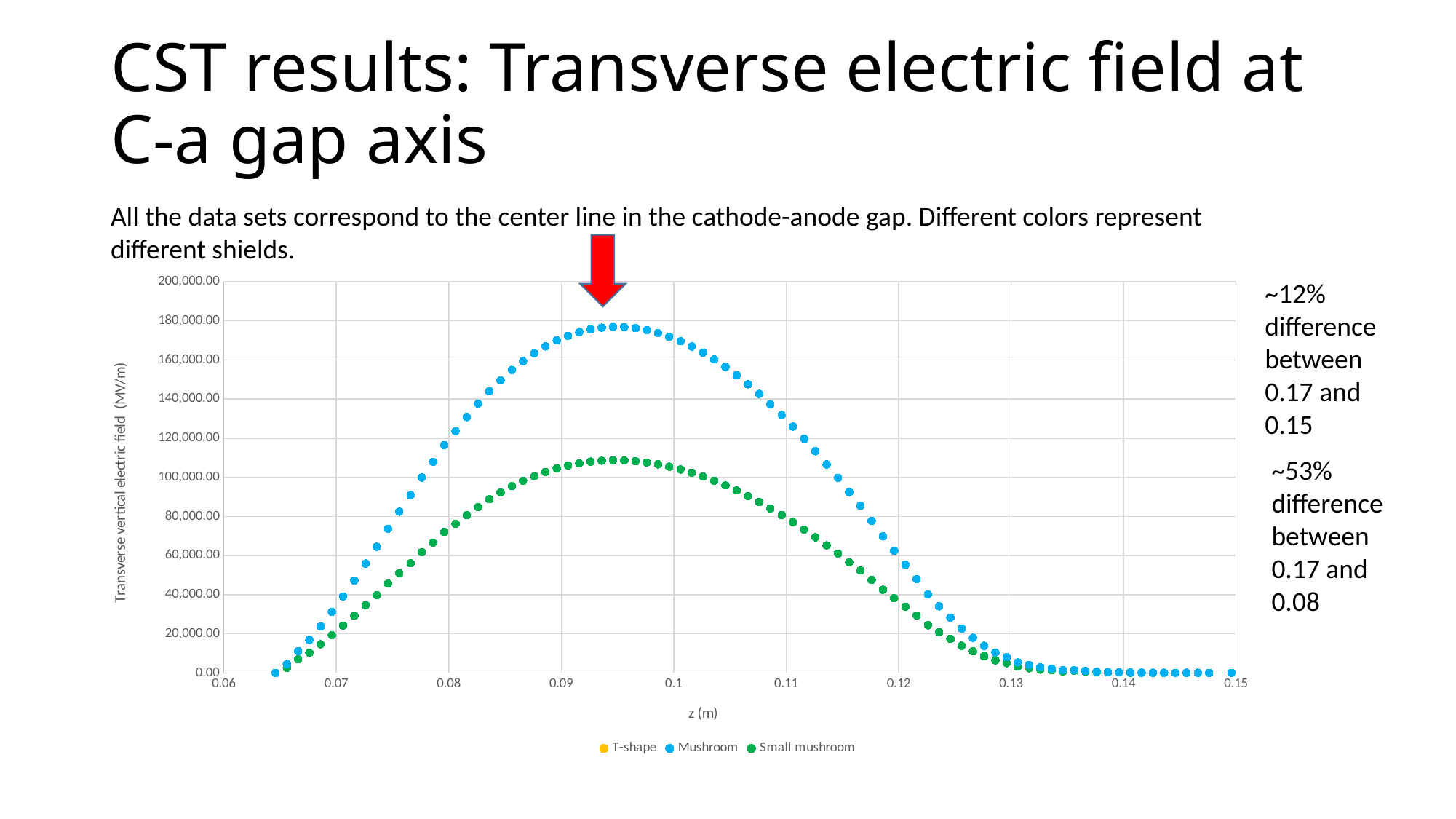
Is the value of the Small mushroom series at z = 0.13 greater or less than 20,000.00? less Is the value of the Small mushroom series at z = 0.08 greater or less than 80,000.00? less What kind of chart is shown on the slide? scatter chart Is the value of the Mushroom series at z = 0.08 greater or less than 100,000.00? greater How do the Mushroom series values change as z increases from 0.1 to 0.14? they fall What is the label of the x axis of the chart? z (m) Which series reaches the higher peak value, Mushroom or Small mushroom? Mushroom Between which two x-axis ticks does the Mushroom series reach its maximum? 0.09 and 0.1 How many series does the chart legend list? 3 What are the series names listed in the chart legend? T-shape, Mushroom, Small mushroom